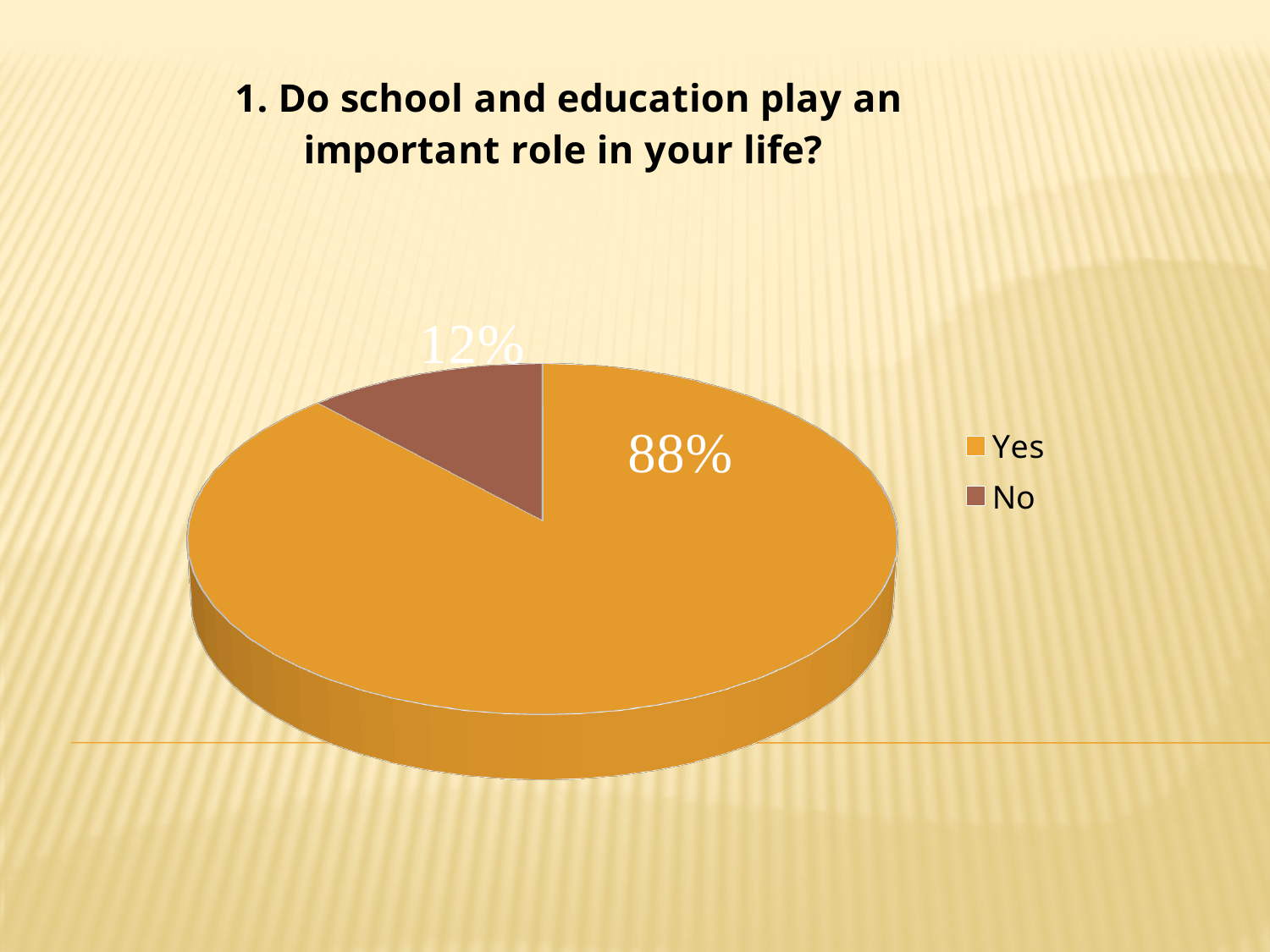
What kind of chart is shown on the slide? Pie chart Which category has the largest slice of the pie? Yes What is the title of the chart? 1. Do school and education play an important role in your life? Which legend entry is shown in the brown colour? No Which category has the smallest slice of the pie? No Which slice is larger, "Yes" or "No"? Yes How many entries does the legend list? 2 What is the difference in percentage points between the "Yes" and "No" slices? 76 How many slices does the pie chart have? 2 What share of the pie is labelled "Yes"? 88% What share of the pie is labelled "No"? 12%